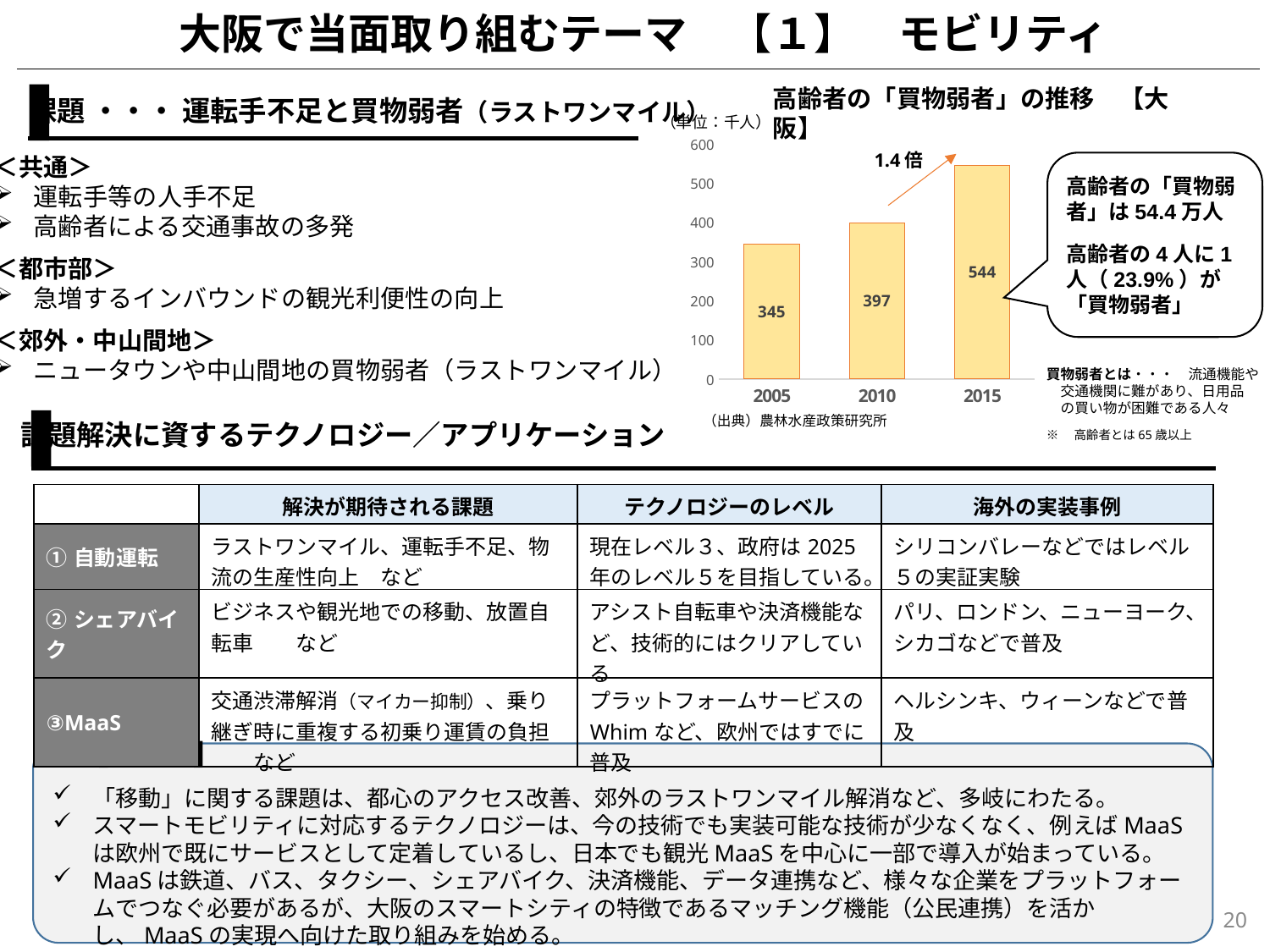
Do the values in the bar chart rise or fall from 2005 to 2015? rise What is the value for 2005 in the bar chart? 345 Which year has the lowest value in the bar chart? 2005 What is the difference between the 2015 and 2005 values in the bar chart? 199 How many years are shown on the x axis of the bar chart? 3 What is the difference between the 2010 and 2005 values in the bar chart? 52 Which is larger in the bar chart, the value for 2010 or the value for 2015? 2015 What is the value for 2010 in the bar chart? 397 What is the value for 2015 in the bar chart? 544 Is the value for 2015 in the bar chart greater or less than 500? greater What kind of chart is shown on the slide? bar chart Which year has the highest value in the bar chart? 2015